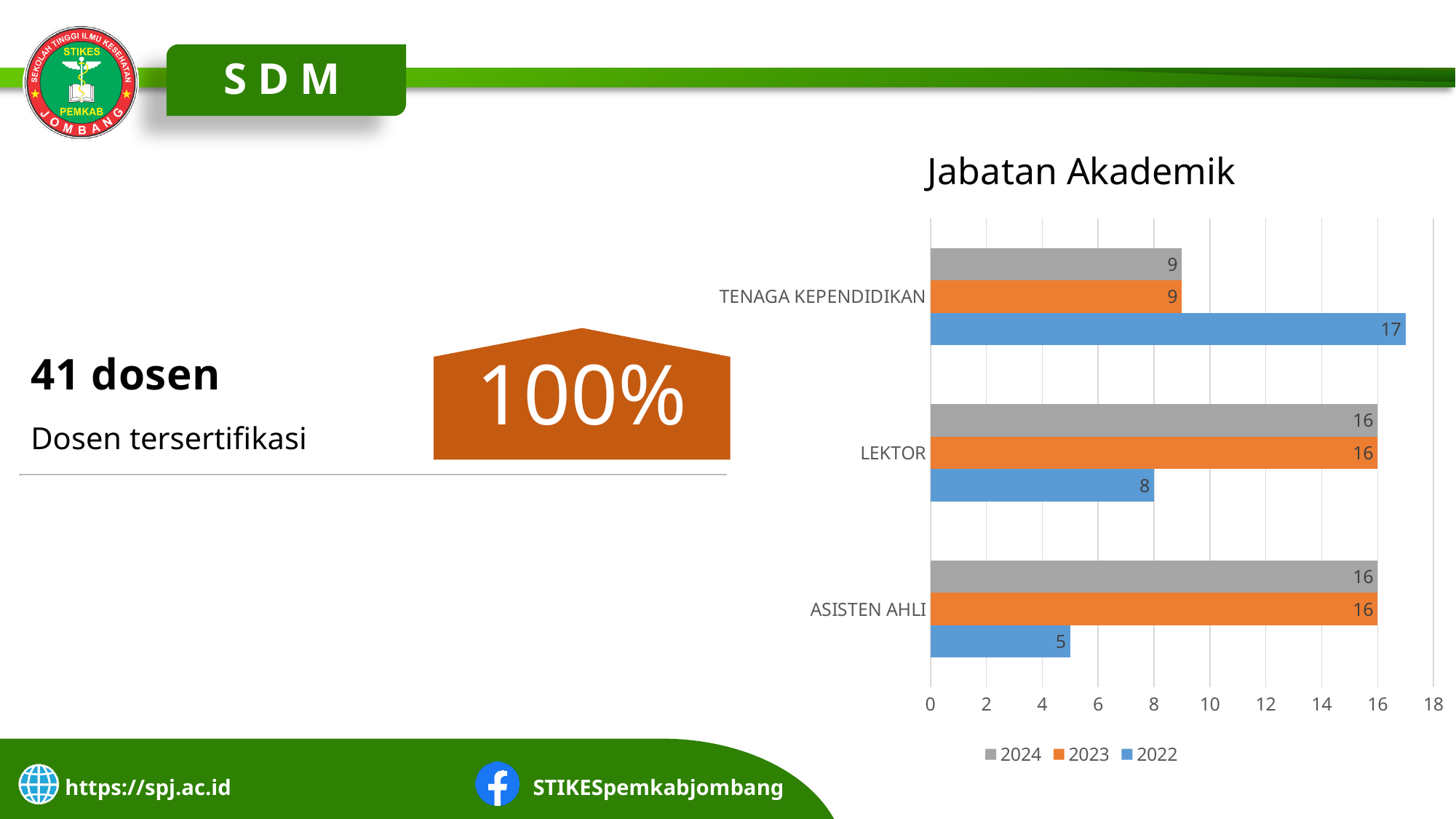
Which category has the lowest 2022 value? ASISTEN AHLI Which category has the highest 2022 value? TENAGA KEPENDIDIKAN What is the title of the chart on the slide? Jabatan Akademik How many series does the legend of the Jabatan Akademik chart list? 3 What is the 2024 value for LEKTOR? 16 What is the 2022 value for ASISTEN AHLI? 5 Which is larger for LEKTOR, the 2023 value or the 2022 value? 2023 What is the 2022 value for TENAGA KEPENDIDIKAN? 17 How many categories are shown on the Jabatan Akademik chart? 3 What is the difference between the 2022 and 2024 values for TENAGA KEPENDIDIKAN? 8 What kind of chart is shown on the slide? bar chart What is the 2023 value for TENAGA KEPENDIDIKAN? 9